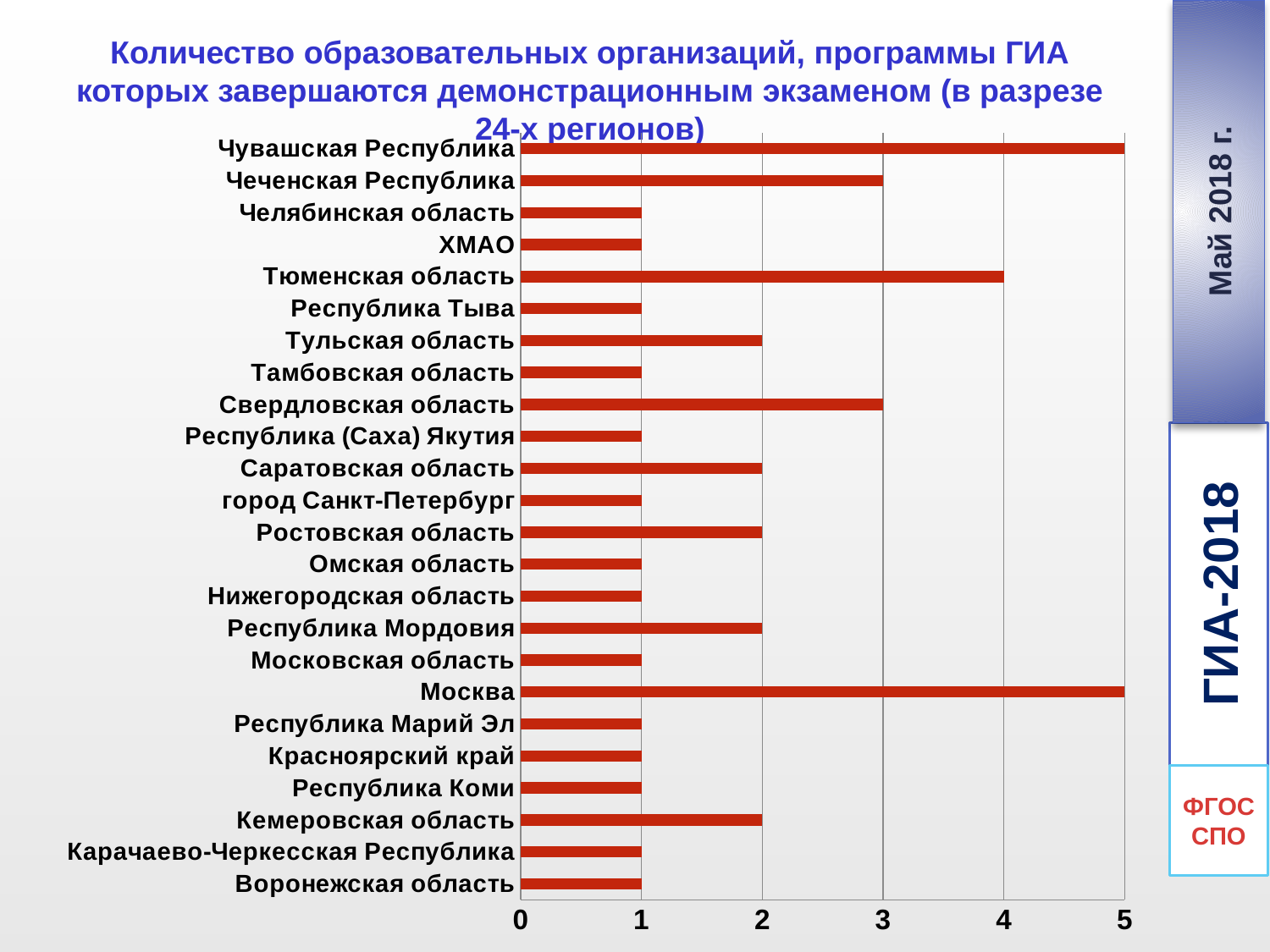
What is the value for Тюменская область? 4 Which is larger, the value for Тюменская область or the value for Свердловская область? Тюменская область What is the value for Свердловская область? 3 What is the difference between the value for Чувашская Республика and the value for Тюменская область? 1 Is the value for Чеченская Республика greater or less than 2? greater What is the value for Тульская область? 2 What is the value for Чеченская Республика? 3 Which two regions have the highest value in the chart? Чувашская Республика and Москва What is the highest value shown on the horizontal axis of the chart? 5 What is the value for Москва? 5 How many regions (categories) are plotted in the chart? 24 What kind of chart is shown on the slide? bar chart